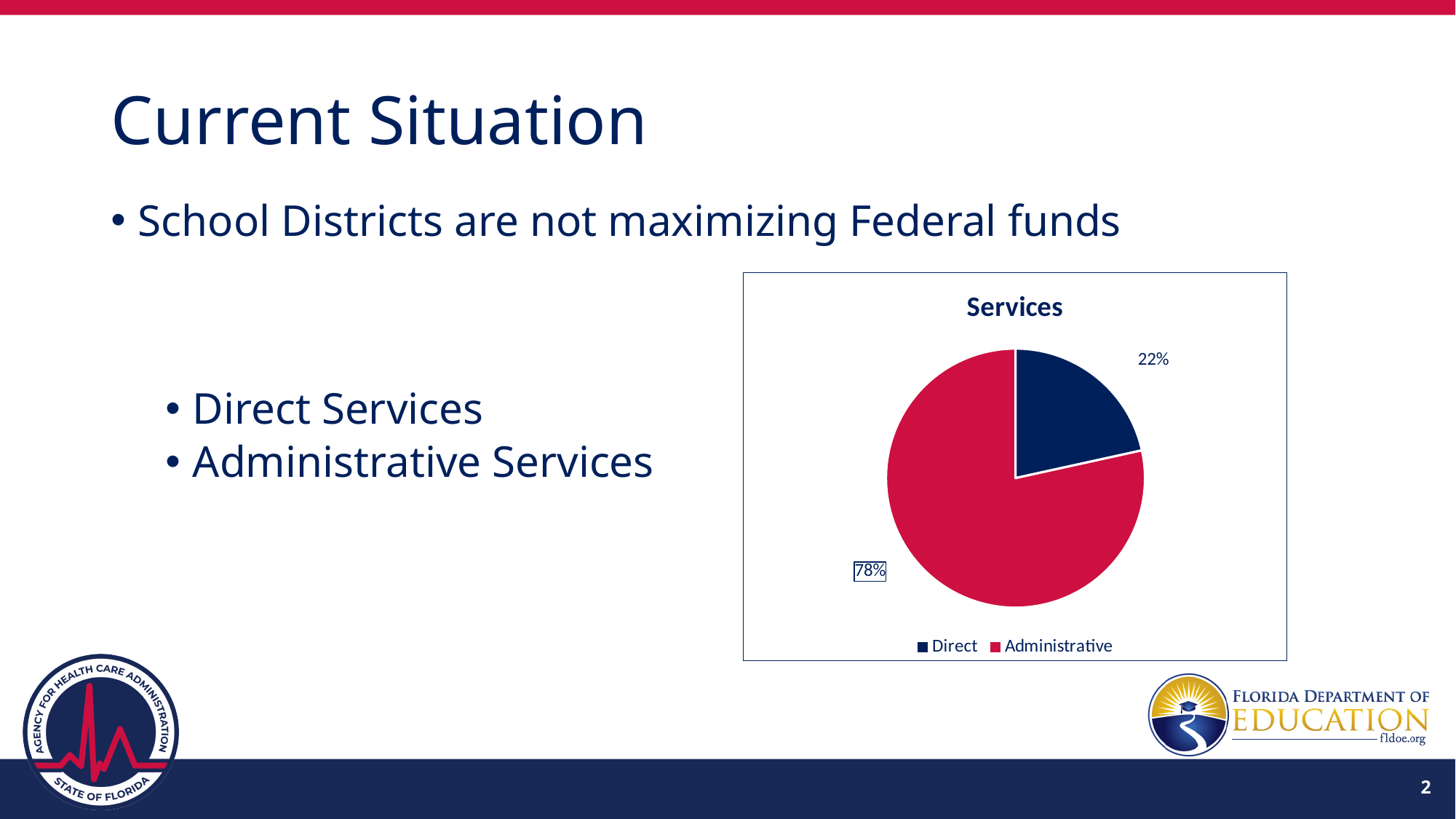
What share of the pie does Direct represent? 22% How many categories does the pie chart show? 2 Which category has the smallest slice of the pie? Direct Which category has the largest slice of the pie? Administrative What type of chart is shown on the slide? pie chart How many entries does the legend list? 2 What is the difference in percentage points between the Administrative and Direct slices? 56 Which is larger, the Direct slice or the Administrative slice? Administrative What share of the pie does Administrative represent? 78% What is the total of the two slice percentages shown? 100% What is the title of the chart? Services What colour is the Administrative slice? red